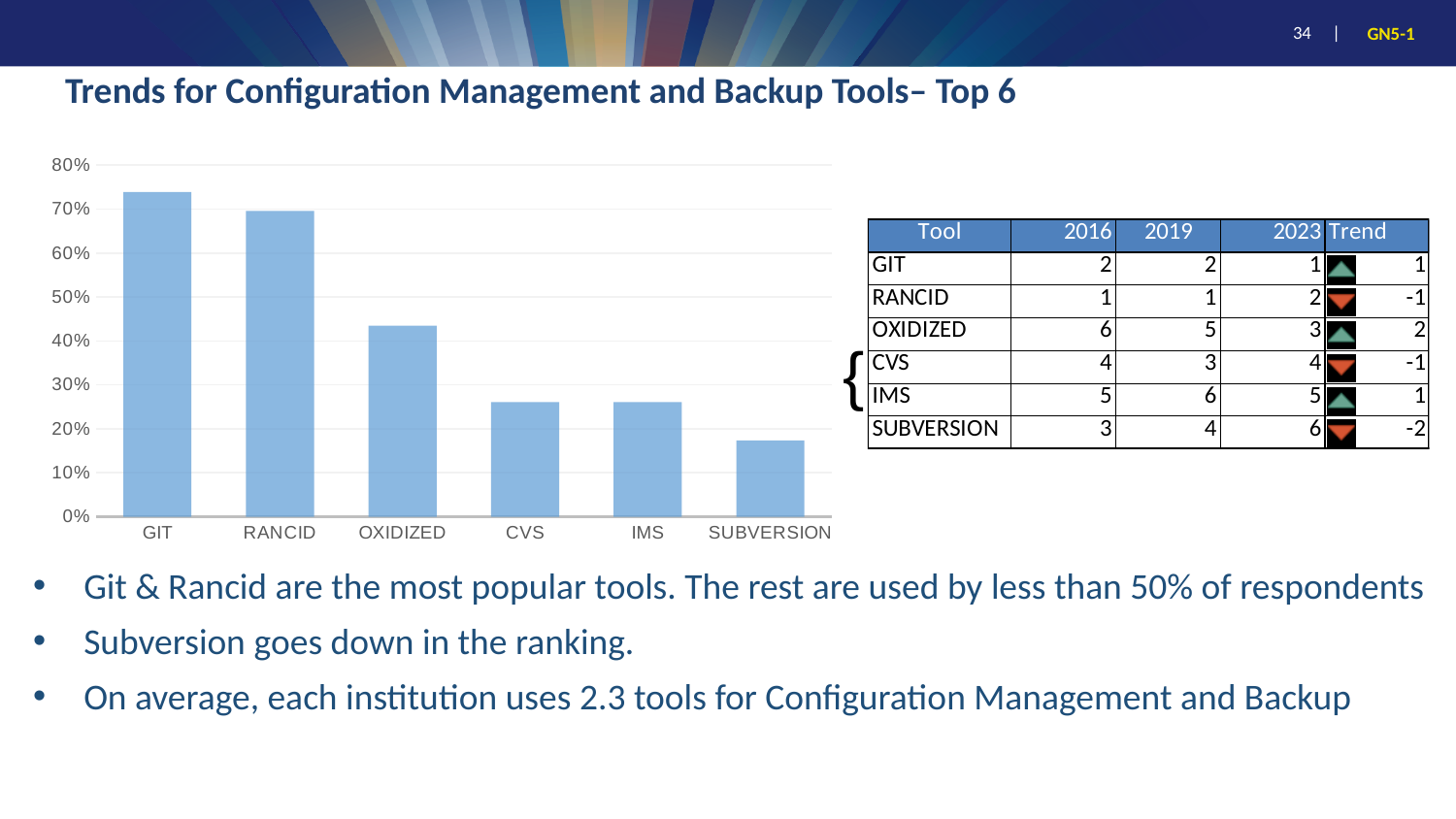
Which tool has the highest bar in the chart? GIT Is the value for GIT greater or less than 70%? greater Which tool has the lowest bar in the chart? SUBVERSION Is the value for OXIDIZED greater or less than 40%? greater Is the value for OXIDIZED greater or less than 50%? less What is the title of the slide containing the chart? Trends for Configuration Management and Backup Tools– Top 6 What kind of chart is shown on the slide? bar chart Which has the larger value, OXIDIZED or CVS? OXIDIZED How many tools are shown on the x axis of the bar chart? 6 Do the bar values generally rise or fall from left to right along the x axis? fall